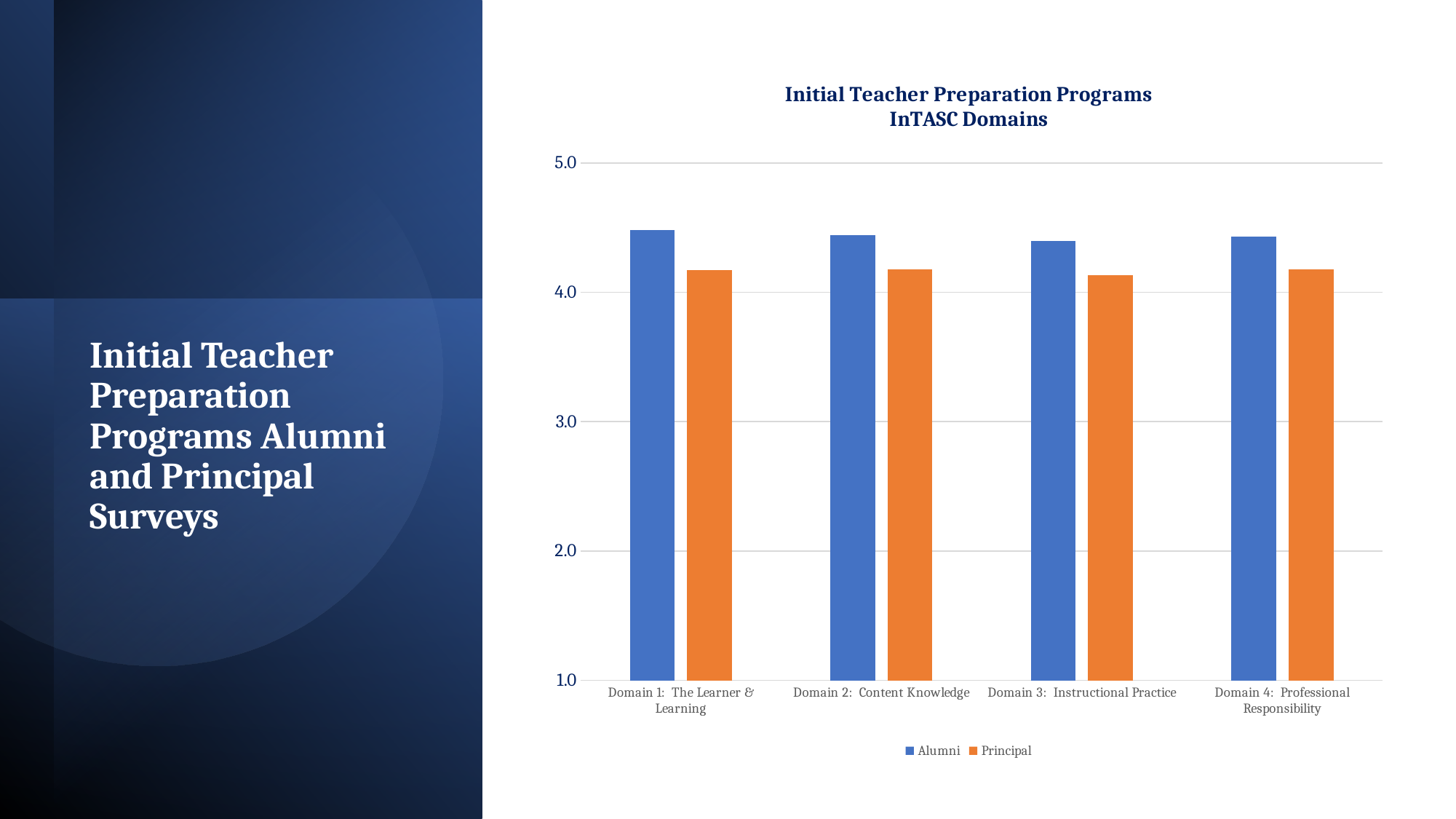
Is the Principal value for Domain 4: Professional Responsibility greater or less than 3.0? greater Is the Alumni value for Domain 2: Content Knowledge greater or less than 4.0? greater Which series is shown in orange in the chart? Principal What kind of chart is shown on the slide? bar chart What is the title of the chart? Initial Teacher Preparation Programs InTASC Domains For Domain 3: Instructional Practice, which is larger, the Alumni value or the Principal value? Alumni For Domain 1: The Learner & Learning, which is larger, the Alumni value or the Principal value? Alumni For Domain 4: Professional Responsibility, which is larger, the Alumni value or the Principal value? Alumni How many domains (categories) are shown on the x axis of the chart? 4 Is the Principal value for Domain 3: Instructional Practice greater or less than 4.0? greater How many series does the chart's legend list? 2